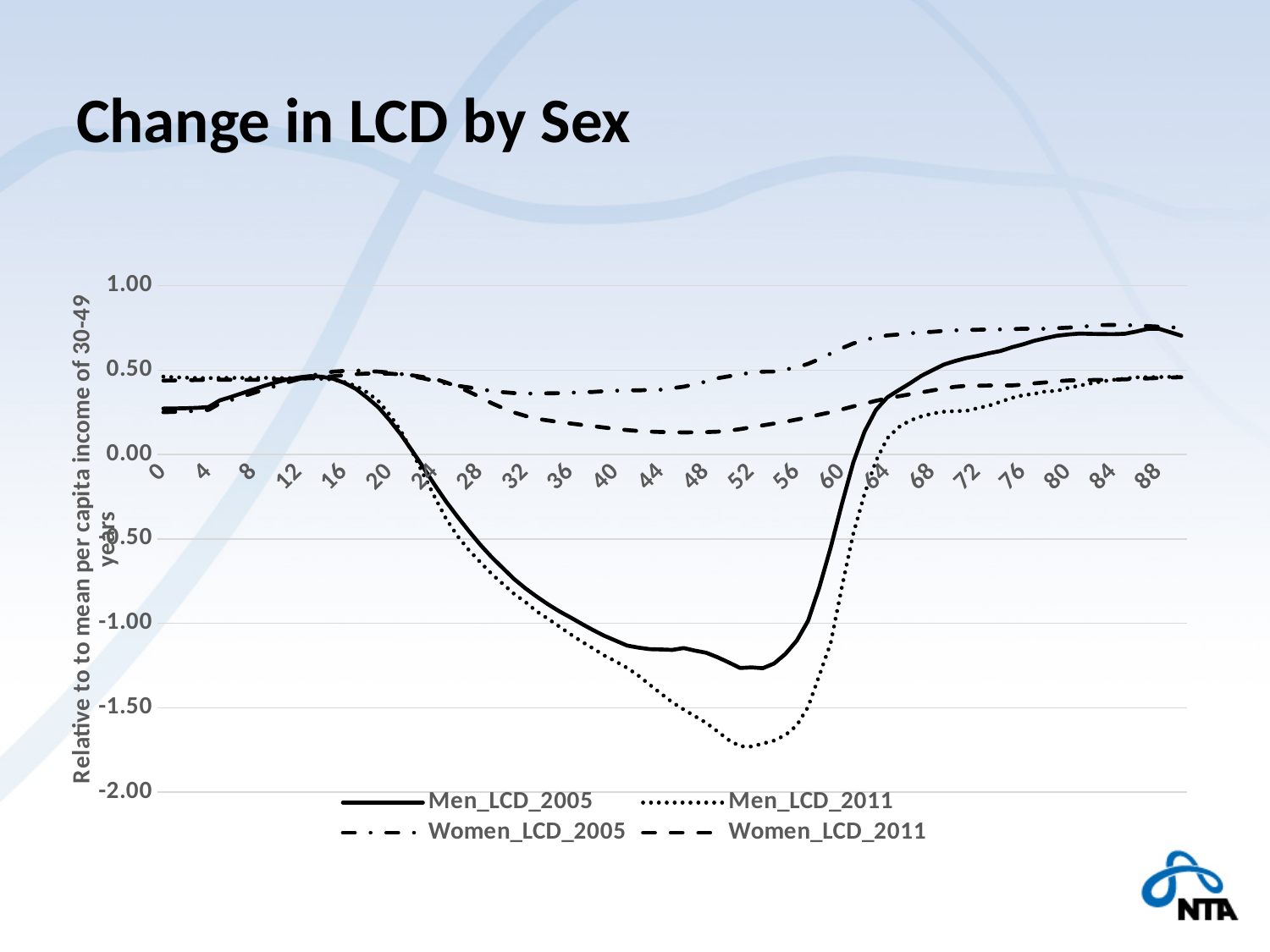
What is the highest age label shown on the x axis? 88 Is the value for Women_LCD_2005 at age 80 greater or less than 0.50? greater At age 48, which is larger: Men_LCD_2005 or Men_LCD_2011? Men_LCD_2005 Does the Men_LCD_2005 line rise or fall between age 24 and age 48? fall What is the title of the chart? Change in LCD by Sex Is the value for Men_LCD_2011 at age 48 greater or less than -1.50? less At age 80, which is larger: Women_LCD_2005 or Women_LCD_2011? Women_LCD_2005 How many series does the legend list? 4 Which series reaches the lowest value on the chart? Men_LCD_2011 Is the value for Men_LCD_2005 at age 48 greater or less than -1.50? greater What kind of chart is shown on the slide? line chart